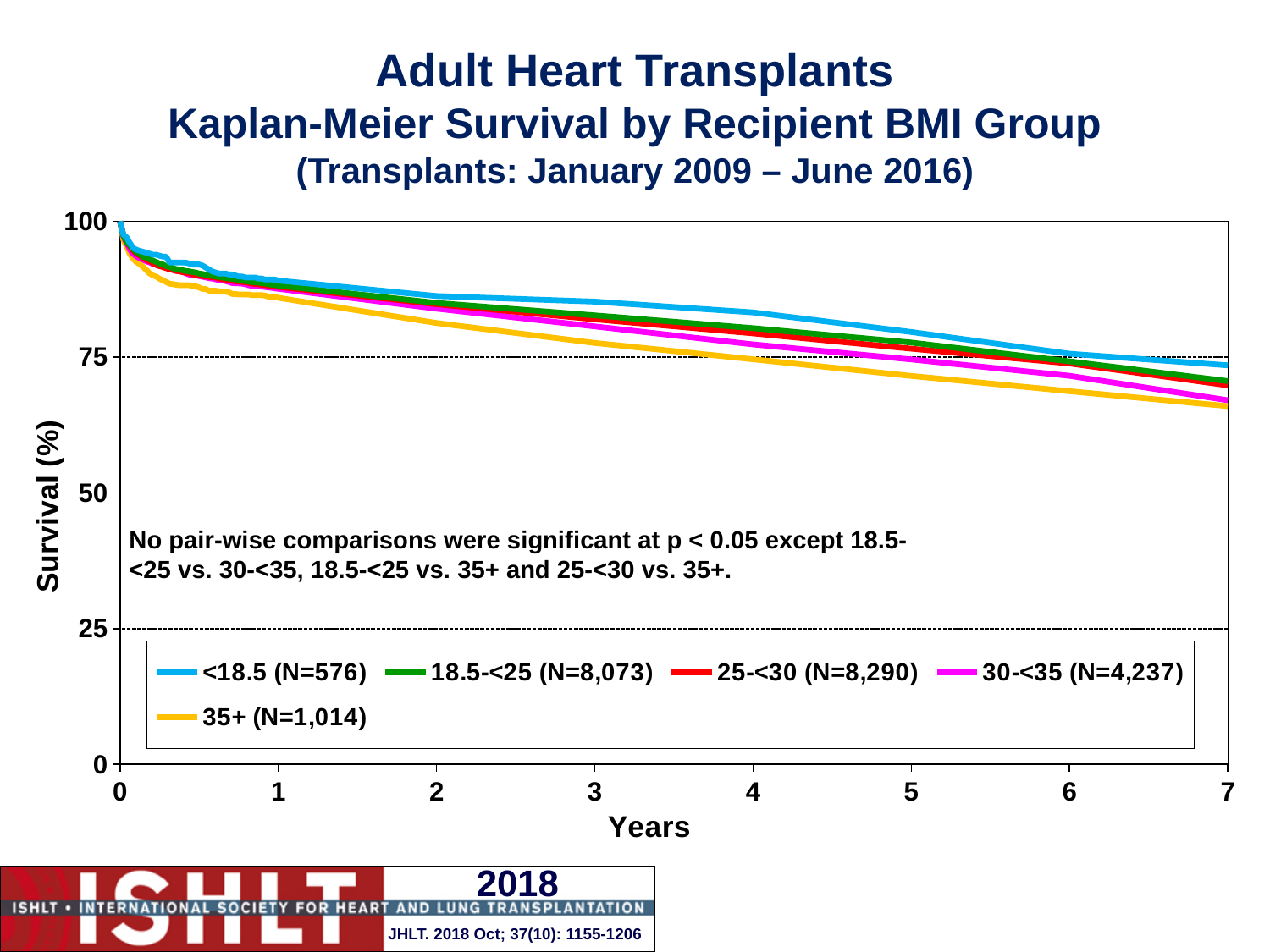
At 5 years, which group has higher survival: <18.5 or 35+? <18.5 How many BMI groups (series) does the legend list? 5 Is the survival for the 35+ group at 2 years greater or less than 75? greater Which BMI group has the lowest survival at 4 years? 35+ Is the survival for the <18.5 group at 5 years greater or less than 75? greater Do the survival curves rise or fall as years since transplant increase? Fall Which BMI group has the largest N according to the legend? 25-<30 (N=8,290) Which BMI group has the highest survival at 7 years? <18.5 What is the N for the <18.5 BMI group shown in the legend? 576 What type of chart is shown on the slide? Line chart Is the survival for the 30-<35 group at 7 years greater or less than 75? less